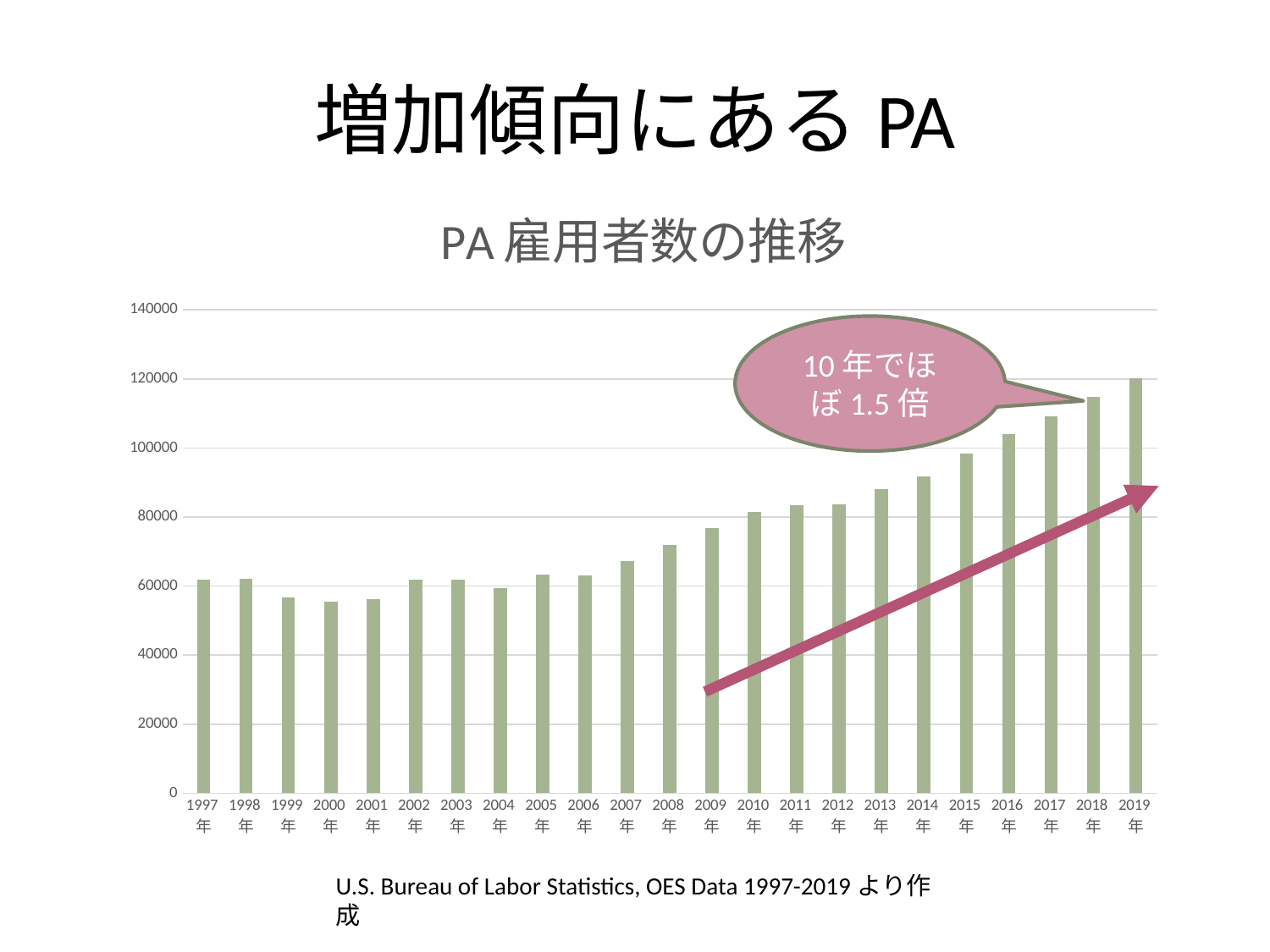
Is the value for 2019年 greater or less than 100000? greater What kind of chart is shown on the slide? bar chart Is the value for 2016年 greater or less than 100000? greater Which year has the highest bar in the chart? 2019年 What is the title of the chart? PA雇用者数の推移 Is the value for 2000年 greater or less than 60000? less Which year has the larger value, 1997年 or 2019年? 2019年 What does the callout bubble on the chart say? 10年でほぼ1.5倍 How many years (bars) are plotted in the chart? 23 Do the values generally rise or fall from 2009年 to 2019年? rise